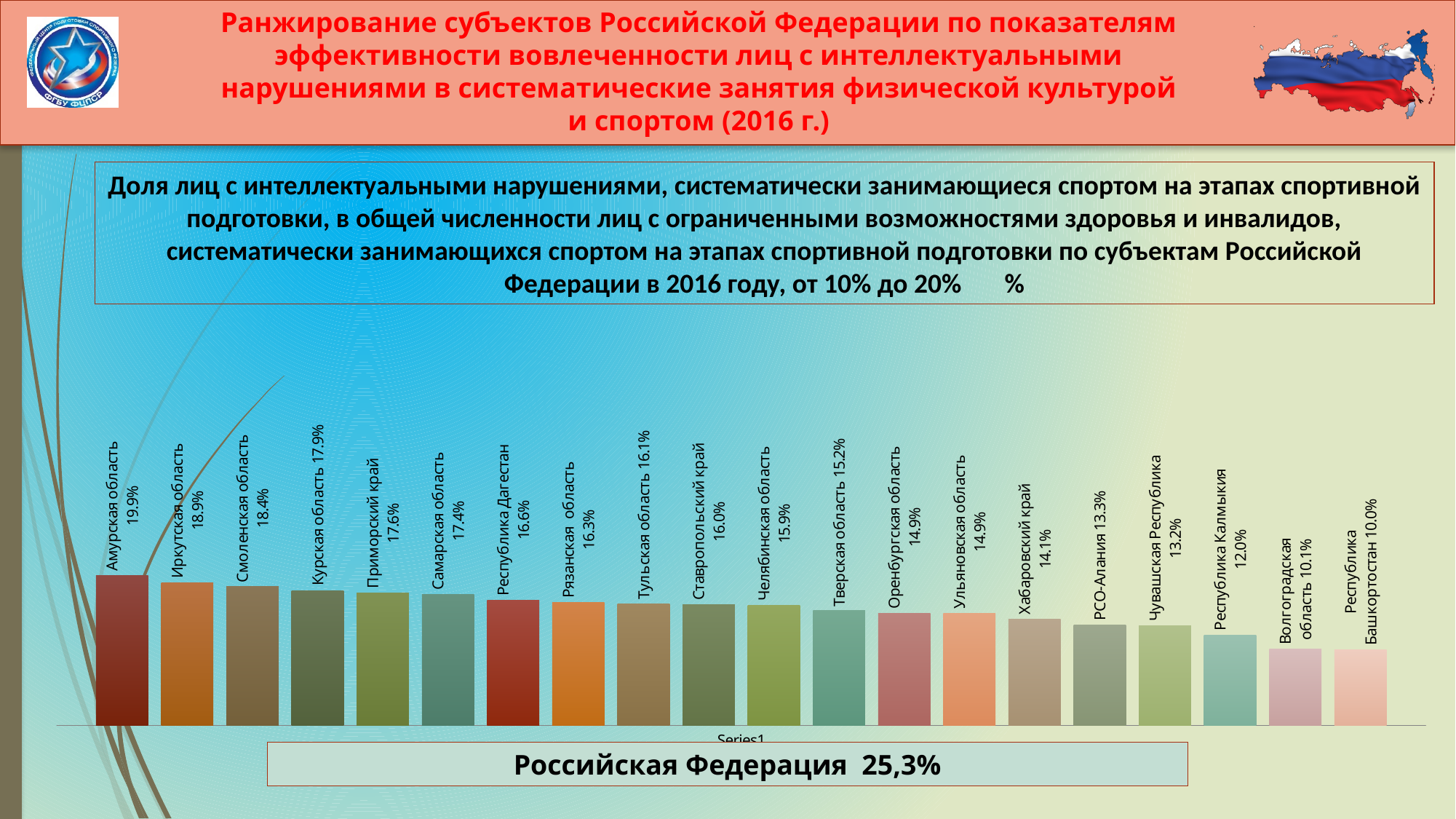
How many regions (bars) are shown in the chart? 20 What value is shown for Республика Калмыкия? 12.0% What value is shown for Тульская область? 16.1% Which region has the highest value in the chart? Амурская область Which has a larger value, Смоленская область or Самарская область? Смоленская область What kind of chart is shown on the slide? Bar chart What value is shown for Хабаровский край? 14.1% What is the difference between the values for Амурская область and Республика Башкортостан? 9.9% What value is shown for Амурская область? 19.9% Do the values rise or fall from left to right across the chart? Fall Which region has the lowest value in the chart? Республика Башкортостан What is the difference between the values for Курская область and Чувашская Республика? 4.7%